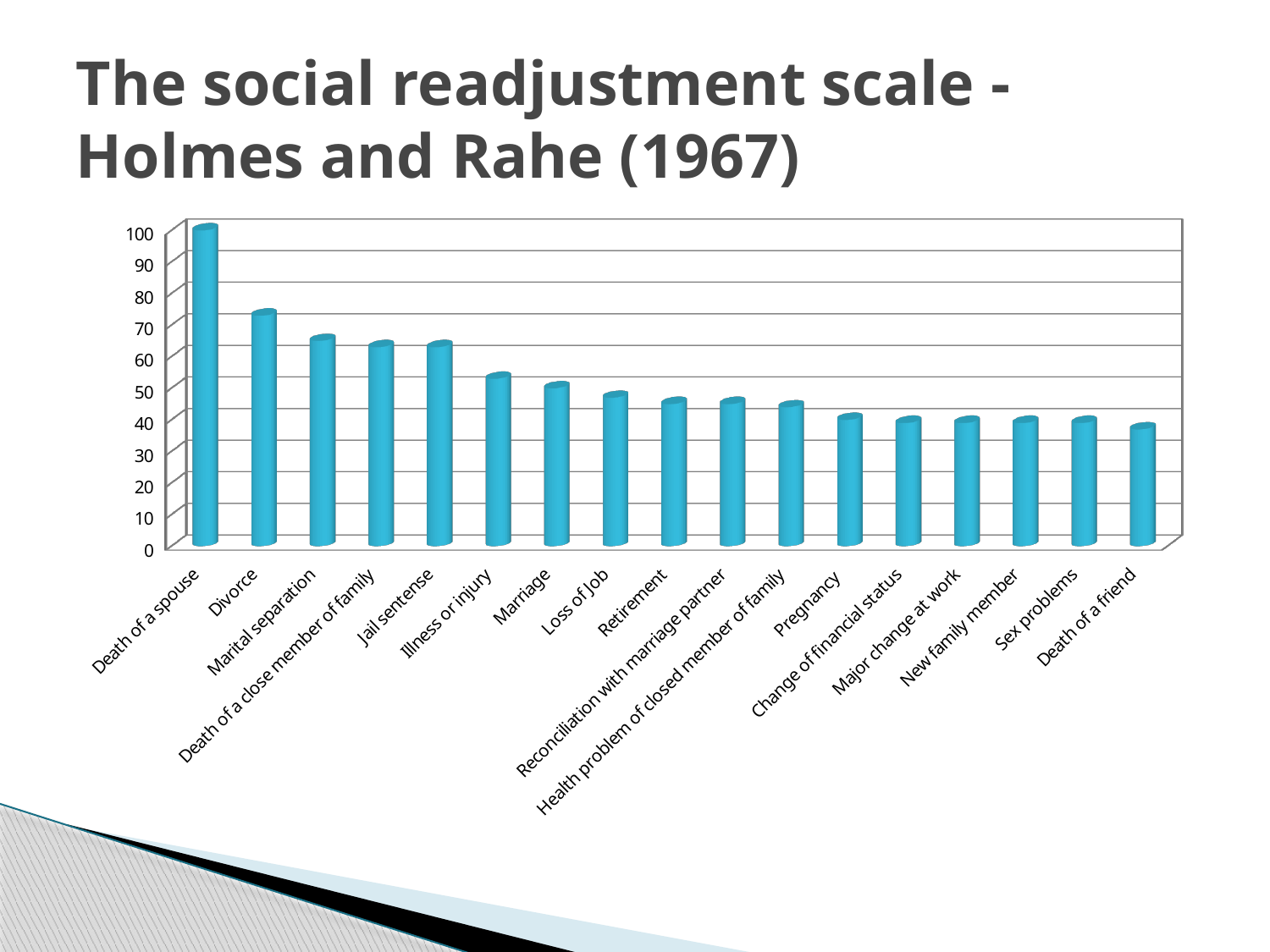
Which category has the highest value on the chart? Death of a spouse Which is larger, the value for Illness or injury or the value for Marriage? Illness or injury Is the value for Death of a friend greater or less than 40? less Do the values rise or fall moving from left to right along the x axis? Fall Which is larger, the value for Divorce or the value for Marital separation? Divorce Is the value for Loss of Job greater or less than 50? less What kind of chart is shown on the slide? Bar chart What is the title of the slide containing the chart? The social readjustment scale - Holmes and Rahe (1967) Is the value for Jail sentense greater or less than 60? greater How many categories are plotted on the chart? 17 Which category has the lowest value on the chart? Death of a friend